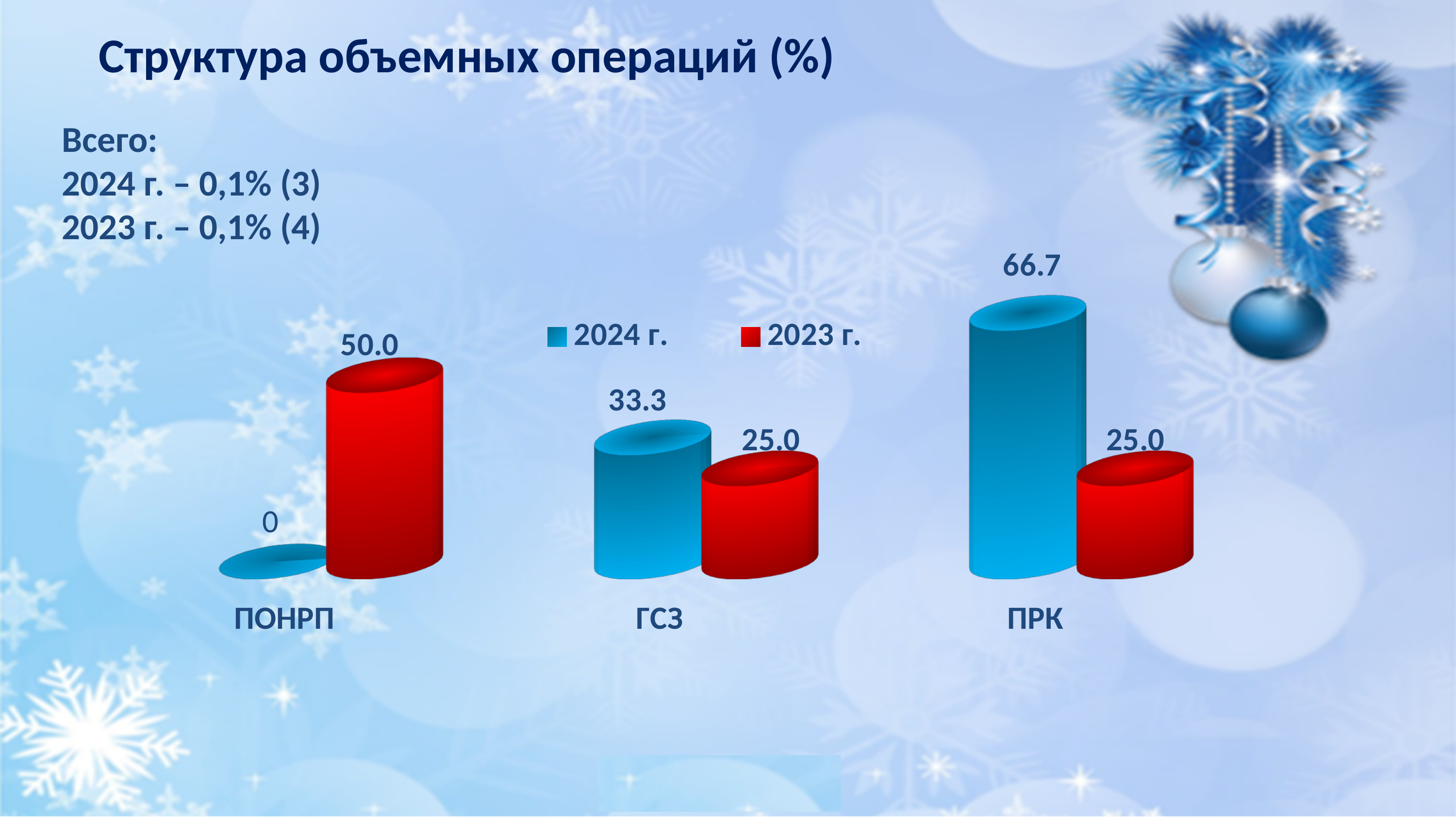
Which category has the lowest value in the 2024 г. series? ПОНРП What is the difference between the 2024 г. and 2023 г. values for ПРК? 41.7 Which category has the highest value in the 2023 г. series? ПОНРП What colour represents the 2023 г. series? red How many series does the legend list? 2 How many categories are shown on the x axis? 3 What is the value for ПОНРП in the 2024 г. series? 0 What is the value for ГСЗ in the 2024 г. series? 33.3 For ГСЗ, which series has the larger value, 2024 г. or 2023 г.? 2024 г. What kind of chart is shown on the slide? bar chart What is the value for ПОНРП in the 2023 г. series? 50.0 What is the value for ПРК in the 2024 г. series? 66.7